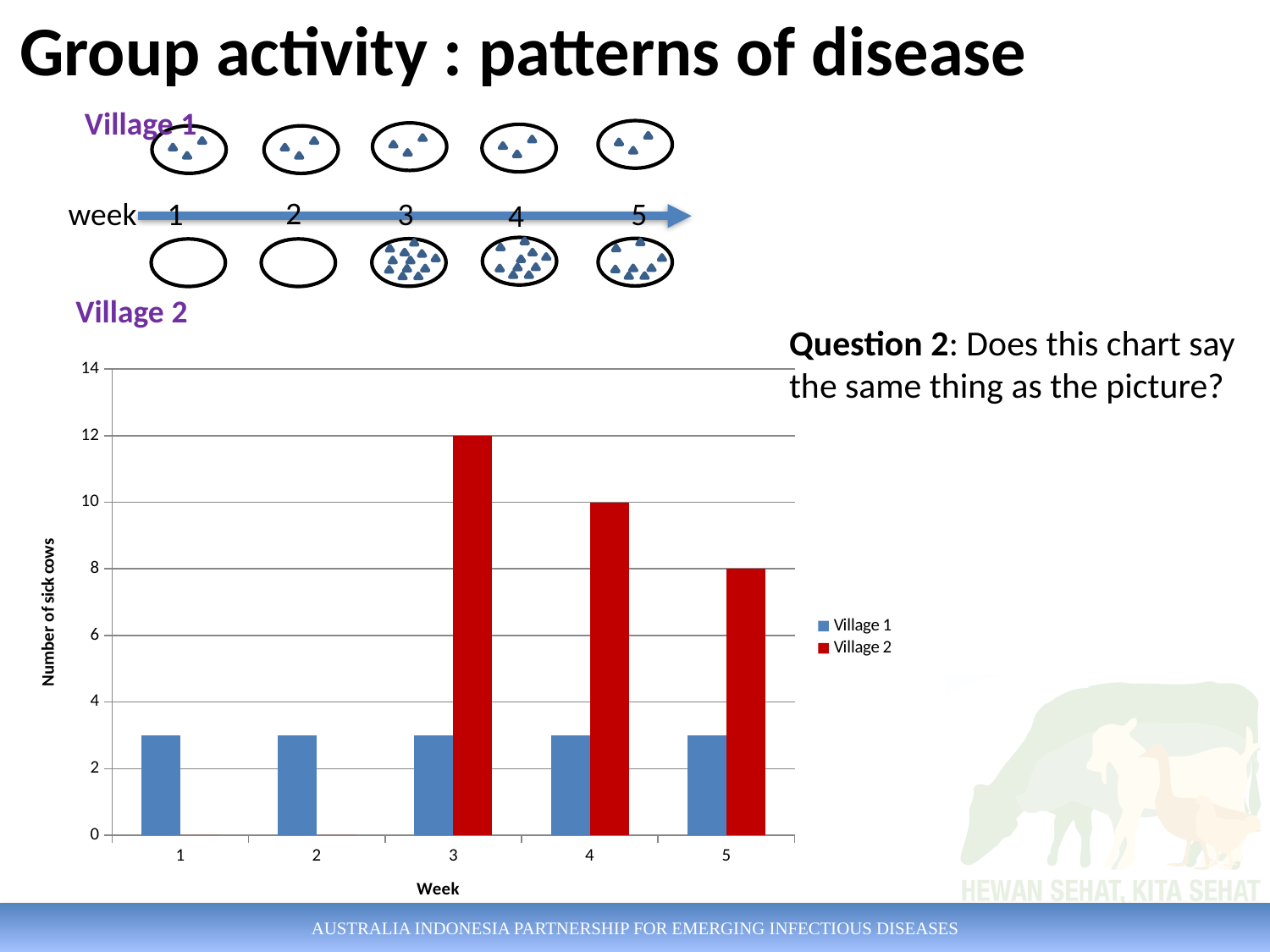
What kind of chart is shown on the slide? bar chart How many weeks are shown on the x axis of the chart? 5 What is the number of sick cows for Village 2 in week 5? 8 Is the value for Village 1 in week 2 greater or less than 4? less What is the number of sick cows for Village 2 in week 4? 10 In week 4, which village has more sick cows, Village 1 or Village 2? Village 2 What is the difference between Village 2's values in week 3 and week 5? 4 In which week is the Village 2 bar highest? 3 What is the title of the chart's vertical axis? Number of sick cows How many series does the chart legend list? 2 What is the number of sick cows for Village 2 in week 3? 12 Do the Village 2 values rise or fall from week 3 to week 5? fall